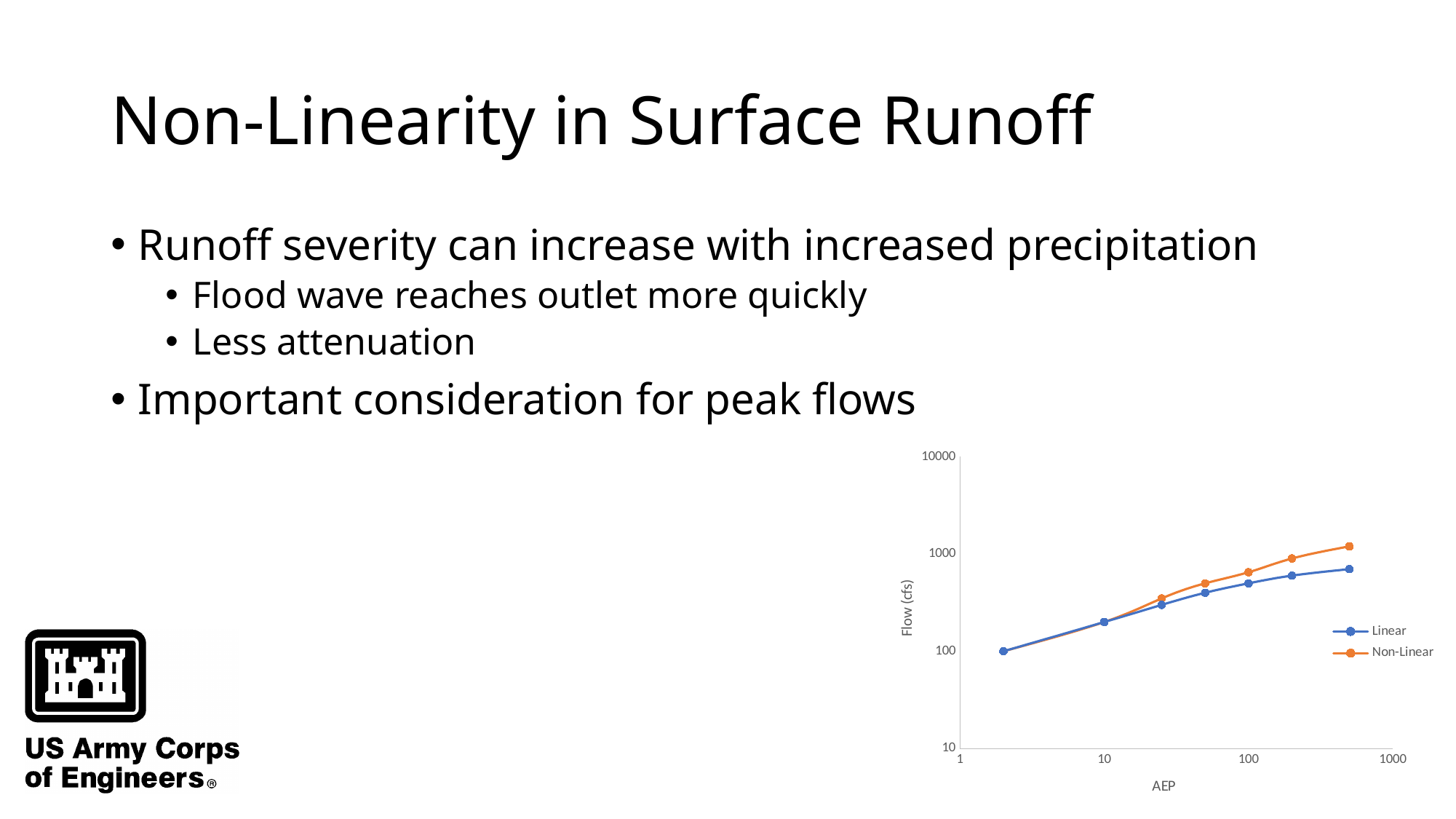
What is the label of the chart's y axis? Flow (cfs) What are the two series named in the chart legend? Linear and Non-Linear How many series does the chart legend list? 2 Do the Flow values for the Linear series rise or fall as AEP increases along the x axis? Rise Do the Flow values for the Non-Linear series rise or fall as AEP increases along the x axis? Rise Which series reaches the highest Flow value on the chart? Non-Linear Is the Flow value for the Linear series at AEP 100 greater or less than 100? greater How many data points are plotted for the Linear series? 7 Is the Flow value for the Linear series at its highest AEP point greater or less than 1000? less At the highest AEP plotted, which series has the larger Flow value, Linear or Non-Linear? Non-Linear What kind of chart is shown on the slide? Line chart